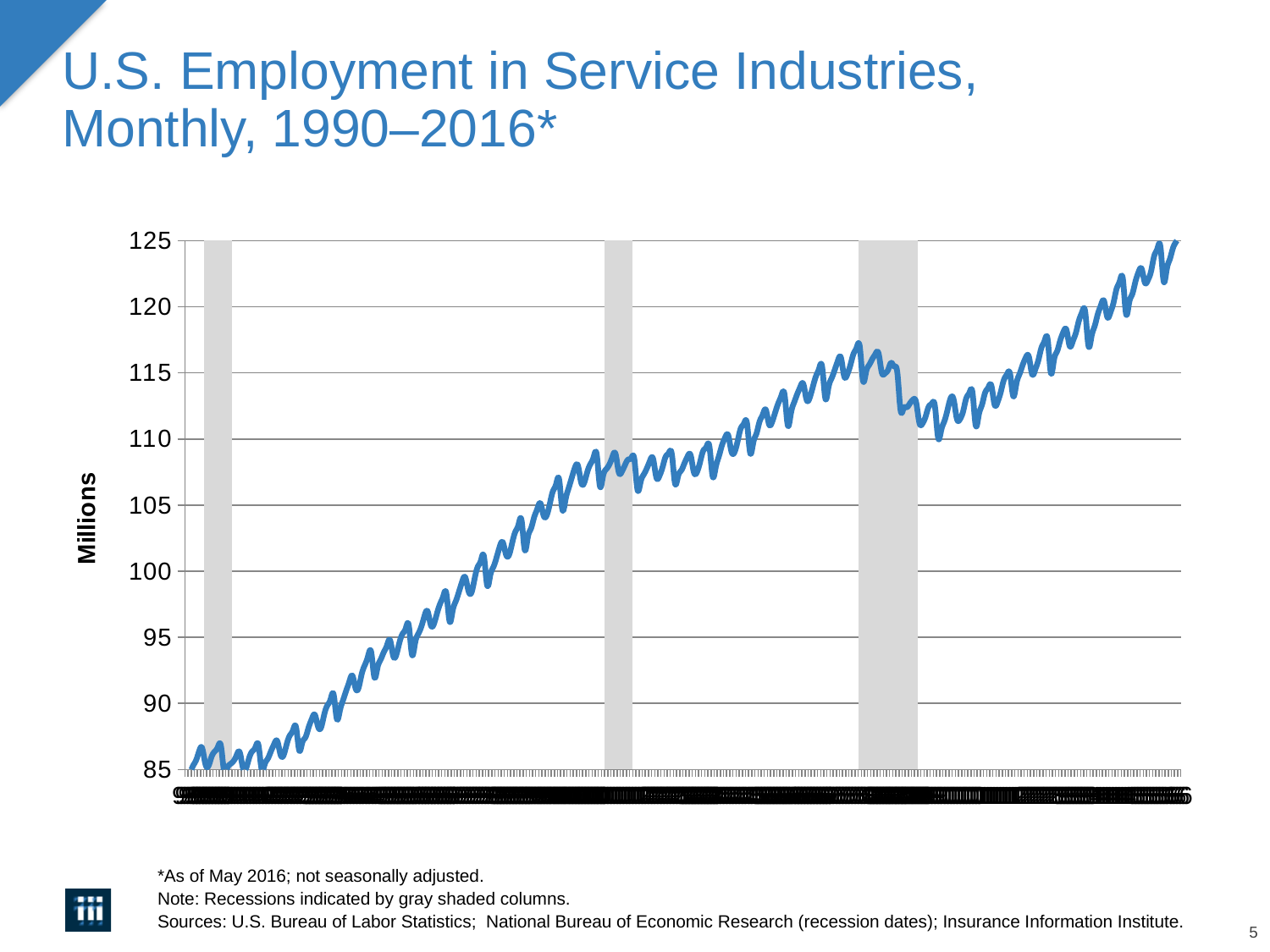
Is the value at the end of the series (May 2016) greater or less than 120? greater What is the label on the vertical axis of the chart? Millions Is the highest point of the series greater or less than 120? greater Is the value at the start of the series (1990) greater or less than 90? less What kind of chart is shown on the slide? line chart What is the title of the chart on the slide? U.S. Employment in Service Industries, Monthly, 1990–2016* What is the highest value shown on the vertical axis? 125 Do the values generally rise or fall from left to right across the chart? rise